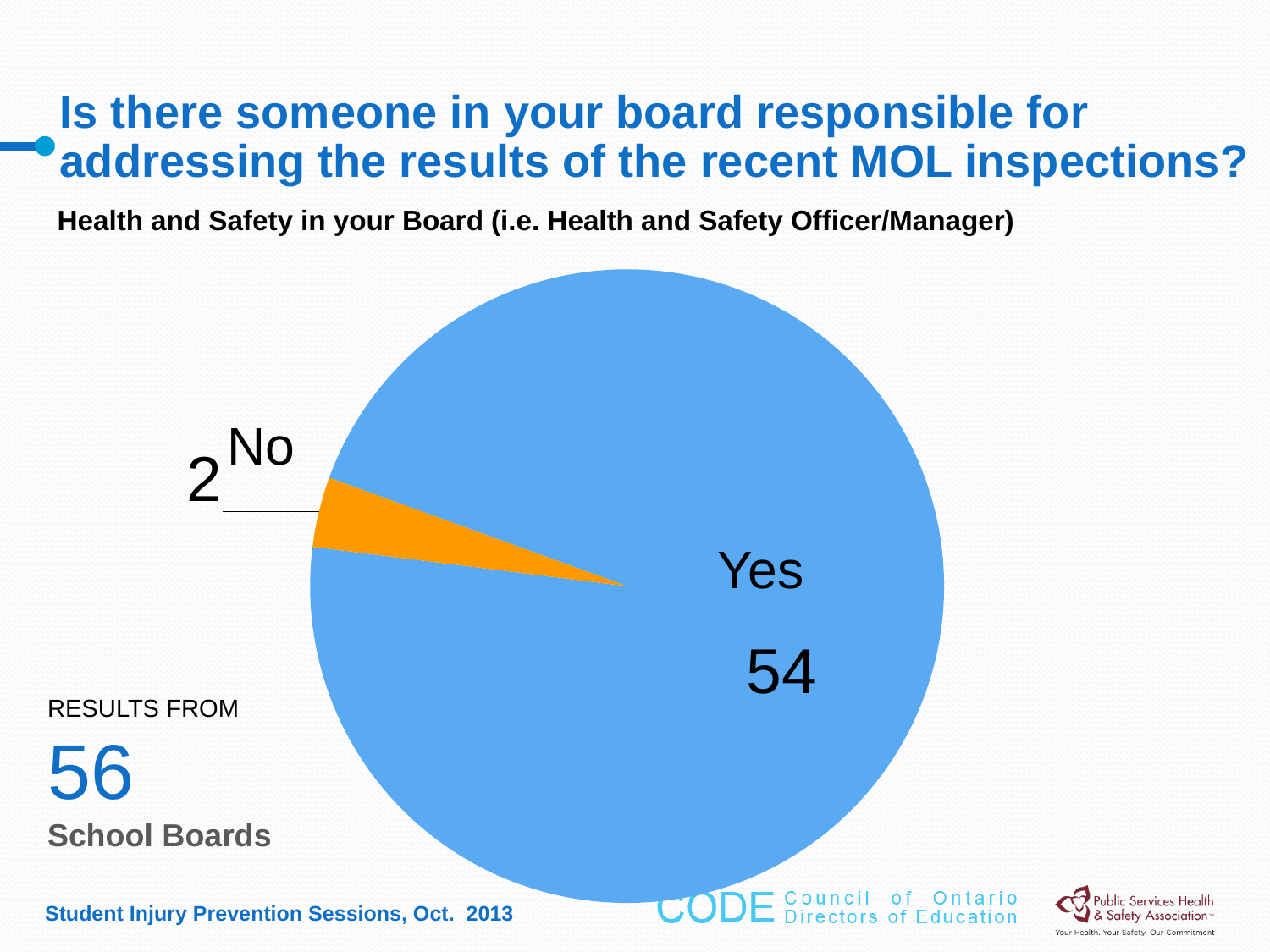
How many school boards answered "Yes"? 54 How many school boards answered "No"? 2 How many slices does the pie chart have? 2 What is the difference between the number of "Yes" and "No" responses? 52 How many school boards do the results come from? 56 What is the total number of responses shown in the pie chart? 56 What colour is the "Yes" slice of the pie? blue Which response has the largest slice of the pie? Yes What colour is the "No" slice of the pie? orange Which response received more answers, "Yes" or "No"? Yes What kind of chart is shown on the slide? pie chart Which response has the smallest slice of the pie? No